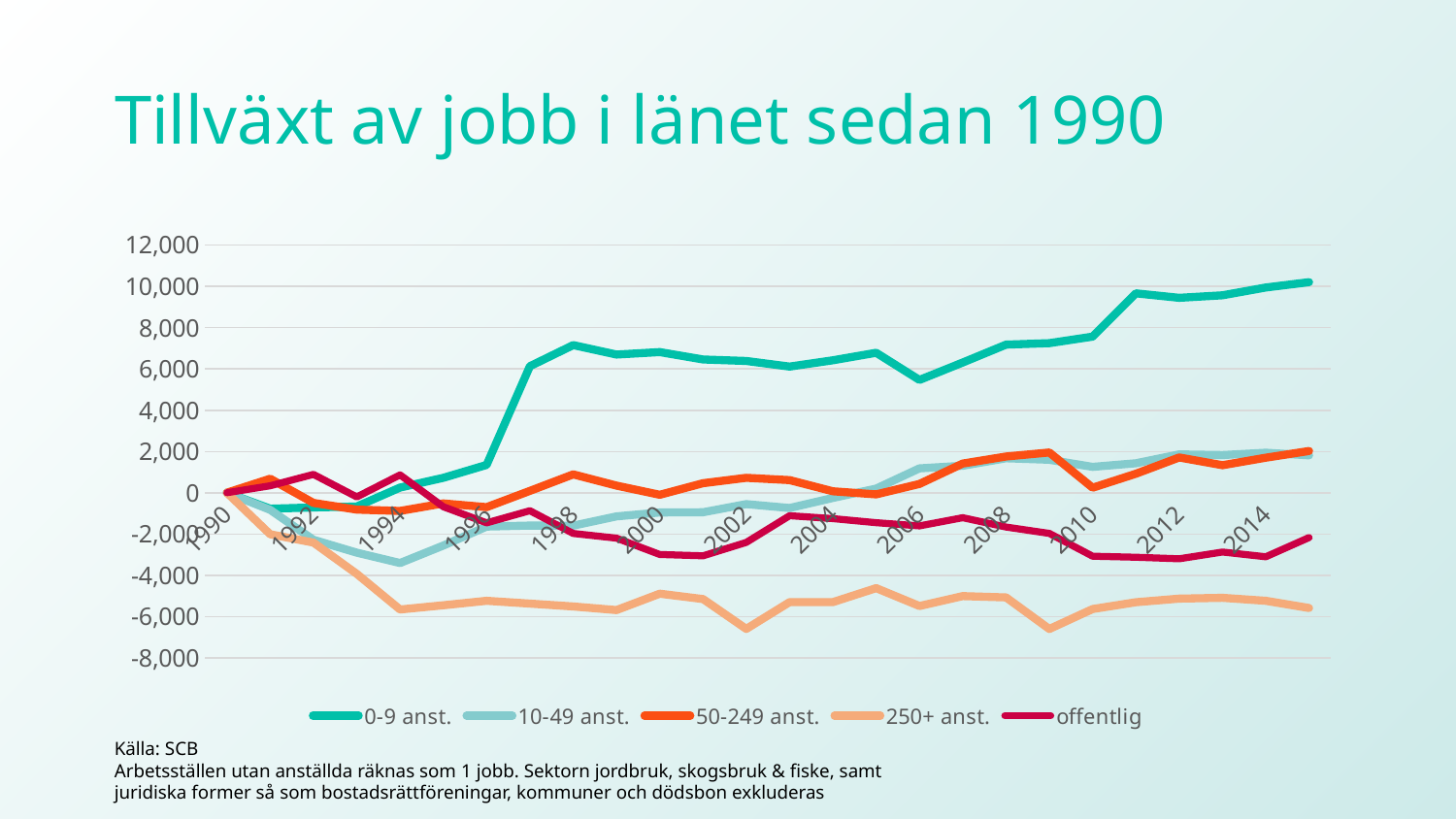
In 2014, which is larger: the value for 0-9 anst. or the value for 250+ anst.? 0-9 anst. What value do all five series share at the starting year 1990? 0 Is the value for offentlig in 2012 greater or less than -2,000? less How many series does the legend list? 5 Which series has the highest value at the right end of the chart (2014–2015)? 0-9 anst. What is the highest value labelled on the vertical axis? 12,000 Which series has the lowest value at the right end of the chart (2014–2015)? 250+ anst. Does the 0-9 anst. series generally rise or fall from 1990 to 2014? rise Is the value for 0-9 anst. in 2014 greater or less than 8,000? greater What is the title of the chart? Tillväxt av jobb i länet sedan 1990 Is the value for 250+ anst. in 2010 greater or less than -4,000? less What kind of chart is shown on the slide? line chart